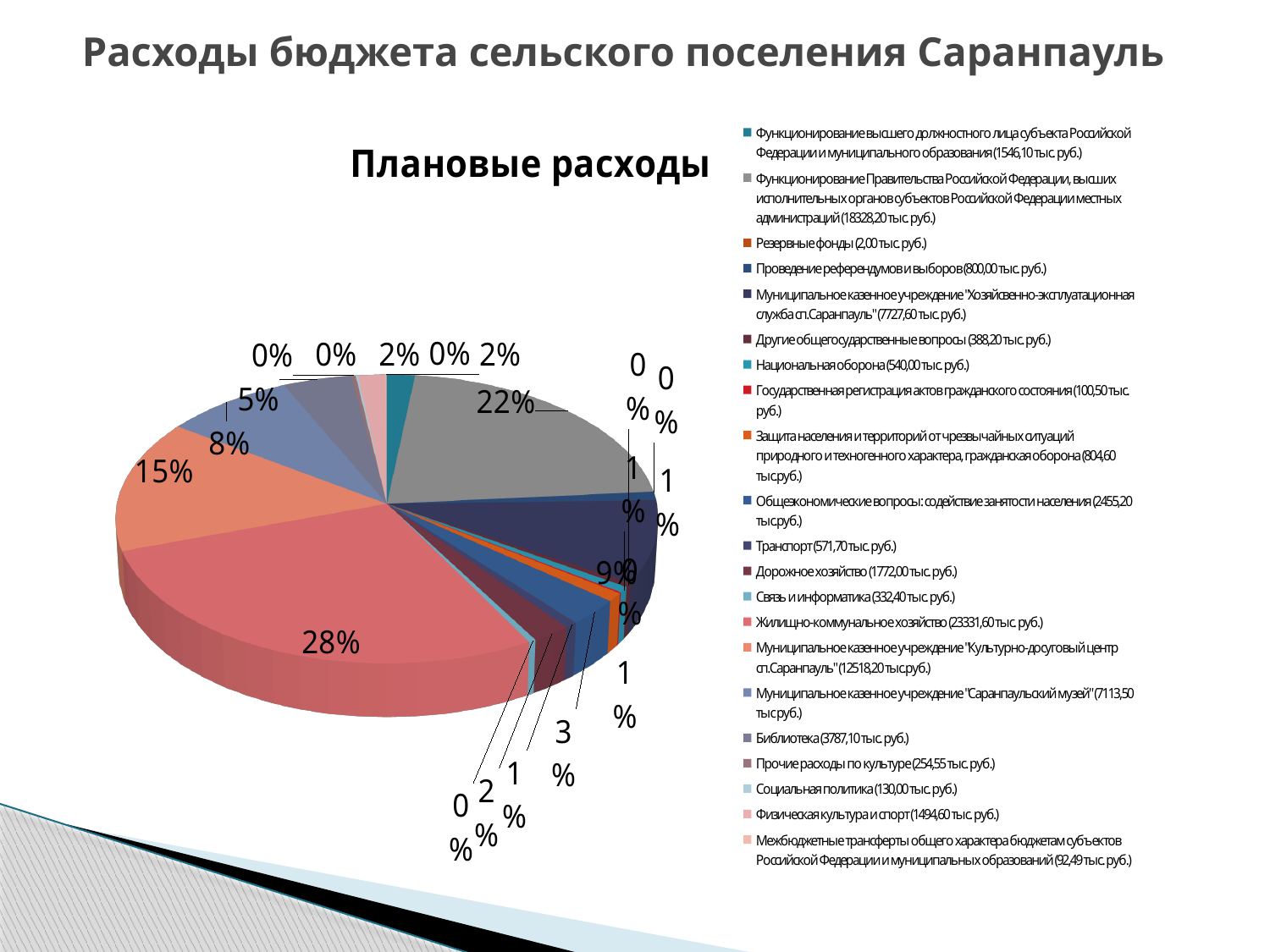
According to the legend, what is the planned amount for Библиотека? 3787,10 тыс. руб. By how much does the legend amount for Жилищно-коммунальное хозяйство exceed that for Функционирование Правительства Российской Федерации? 5003,40 тыс. руб. According to the legend, which category has the smallest planned amount? Резервные фонды (2,00 тыс. руб.) What share of the pie does Муниципальное казенное учреждение "Культурно-досуговый центр сп.Саранпауль" take? 15% According to the legend, what is the planned amount for Дорожное хозяйство? 1772,00 тыс. руб. Which category has the largest slice of the pie? Жилищно-коммунальное хозяйство Which is larger: the slice for Жилищно-коммунальное хозяйство or the slice for Функционирование Правительства Российской Федерации? Жилищно-коммунальное хозяйство What share of the pie does Функционирование Правительства Российской Федерации, высших исполнительных органов субъектов Российской Федерации, местных администраций take? 22% What is the title of the chart? Плановые расходы What kind of chart is shown on the slide? Pie chart How many categories does the legend of the pie chart list? 21 What share of the pie does Жилищно-коммунальное хозяйство take? 28%